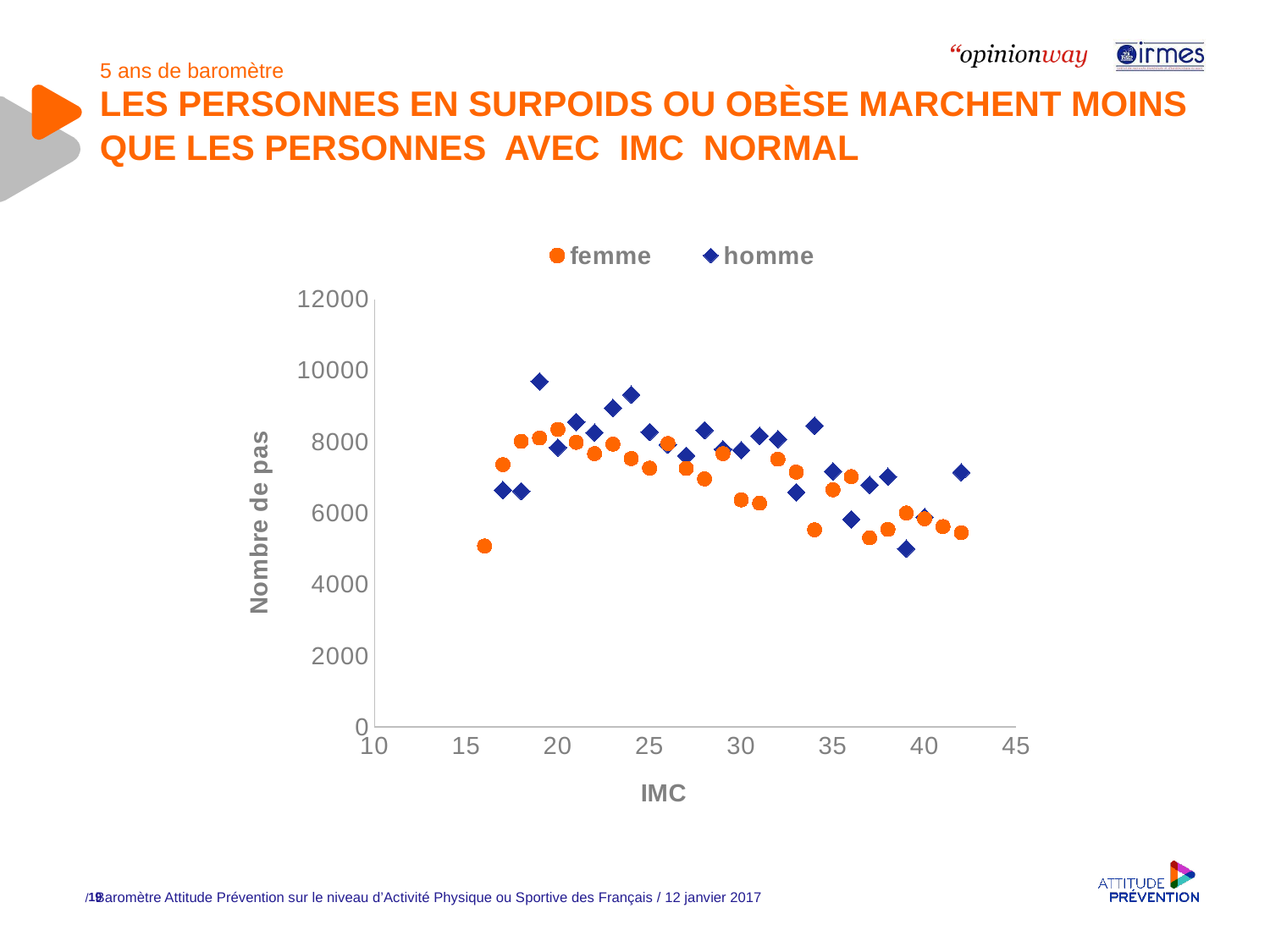
At IMC 34, which series has the higher number of steps, femme or homme? homme Is the value for homme at IMC 24 greater or less than 8000? greater Is the value for homme at IMC 19 greater or less than 8000? greater What are the two series named in the legend? femme and homme What is the label of the x axis? IMC At IMC 19, which series has the higher number of steps, femme or homme? homme Is the value for femme at IMC 34 greater or less than 6000? less What kind of chart is shown on the slide? scatter chart How many series does the legend list? 2 Overall, do the number of steps rise or fall as IMC increases along the x axis? fall